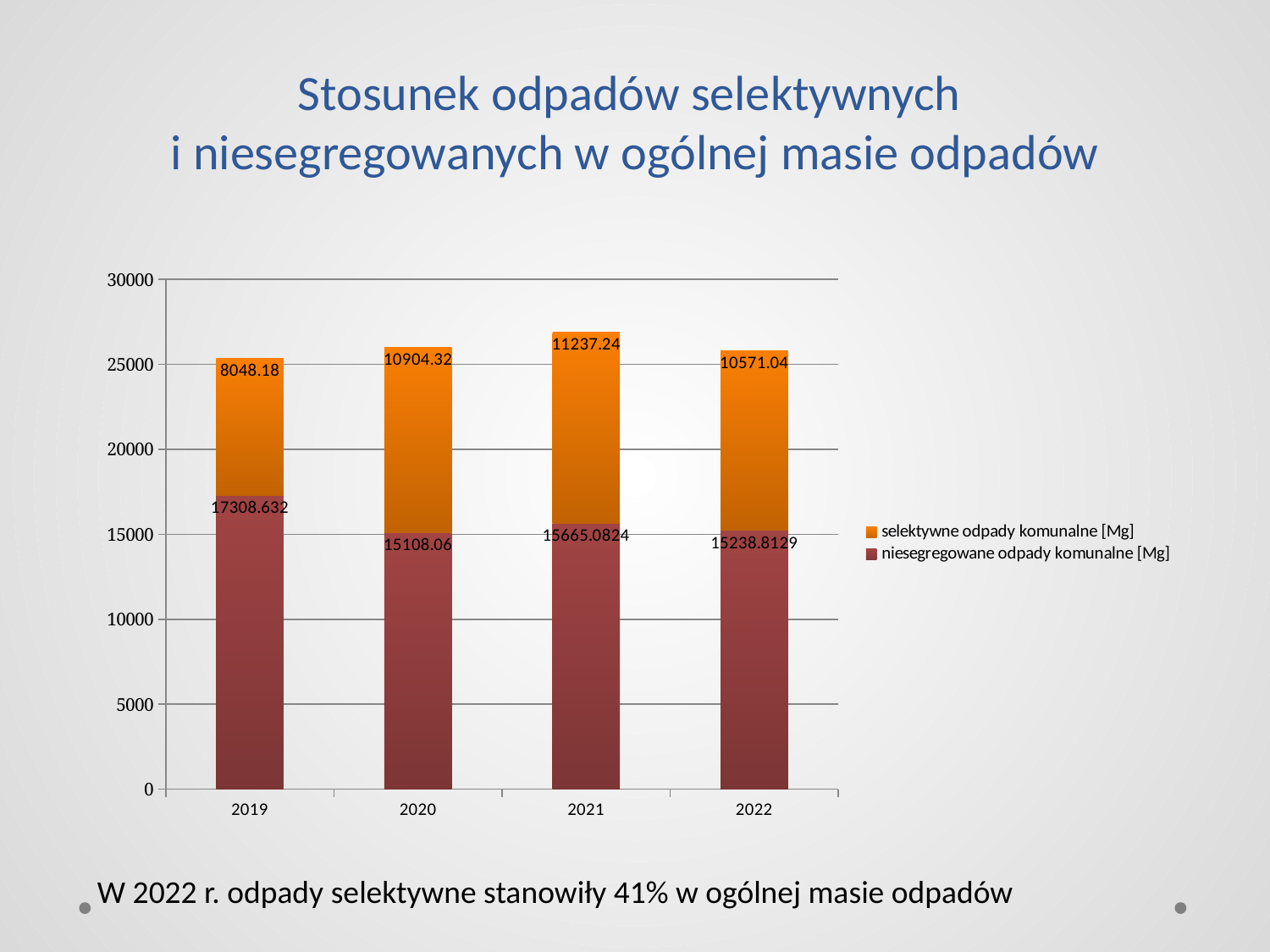
Which is larger: niesegregowane odpady komunalne [Mg] in 2019 or in 2020? 2019 What is the difference between the selektywne odpady komunalne [Mg] values for 2021 and 2019? 3189.06 What kind of chart is shown on the slide? stacked bar chart What is the value of niesegregowane odpady komunalne [Mg] for 2021? 15665.0824 How many years are shown on the x axis? 4 How many series does the legend list? 2 What is the value of niesegregowane odpady komunalne [Mg] for 2022? 15238.8129 Is the value of niesegregowane odpady komunalne [Mg] for 2019 greater or less than 15000? greater In which year is the value of selektywne odpady komunalne [Mg] the highest? 2021 What is the value of selektywne odpady komunalne [Mg] for 2019? 8048.18 In which year is the value of niesegregowane odpady komunalne [Mg] the lowest? 2020 What is the total of the stacked bar for 2020? 26012.38